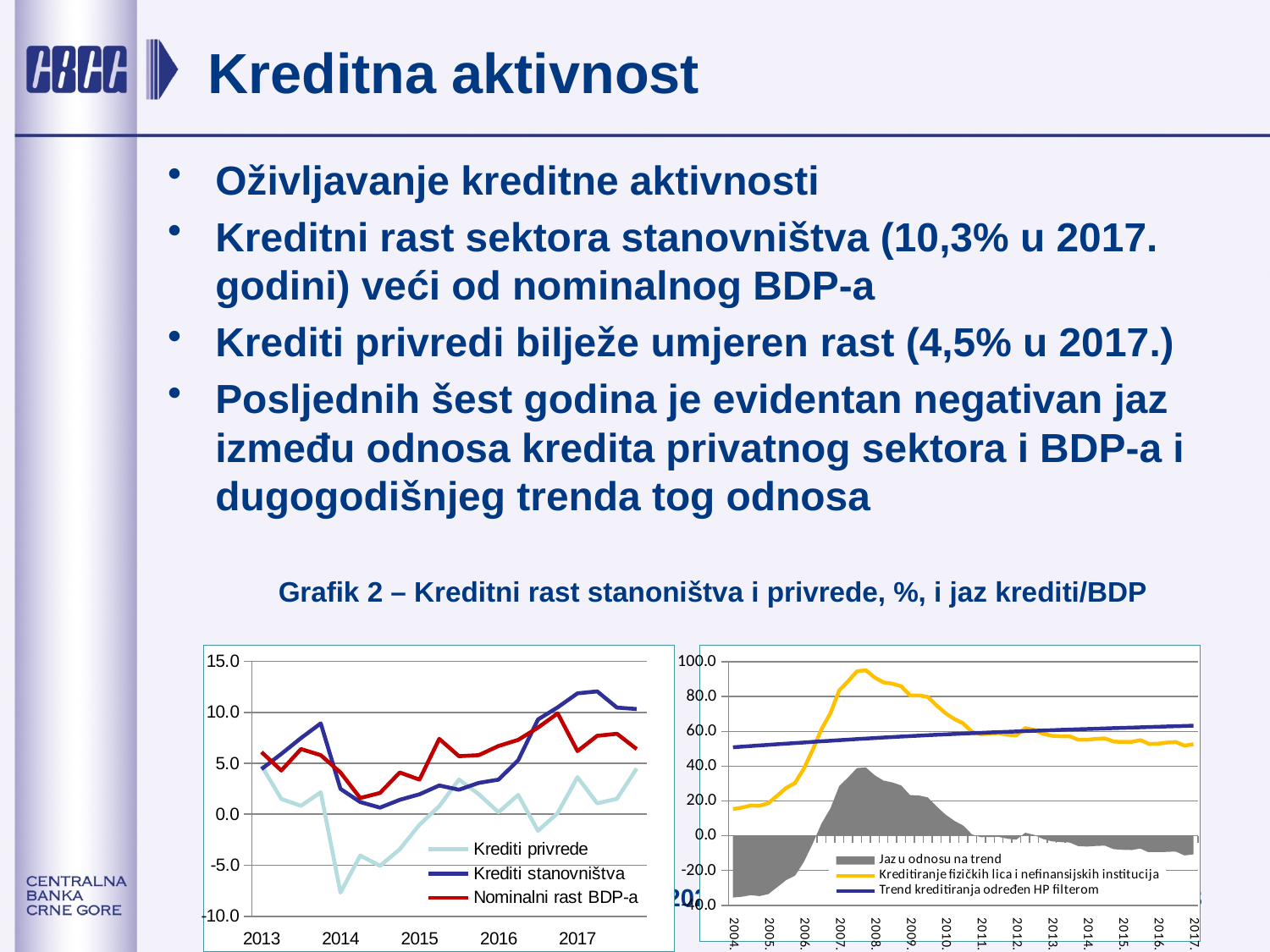
What is the title shown above the two charts? Grafik 2 – Kreditni rast stanoništva i privrede, %, i jaz krediti/BDP How many years are labelled on the x axis of the left chart? 5 In the left chart, is the lowest value of Krediti privrede in 2014 greater or less than -5.0? less In the left chart, is the peak value of Krediti stanovništva in 2017 greater or less than 10.0? greater In the right chart, which series has the highest value in 2008? Kreditiranje fizičkih lica i nefinansijskih institucija How many series does the legend of the left chart list? 3 How many series does the legend of the right chart list? 3 In the right chart, is the value of Jaz u odnosu na trend in 2004 greater or less than -20.0? less In the left chart, which series is higher in 2017: Krediti stanovništva or Krediti privrede? Krediti stanovništva In the right chart, does the Trend kreditiranja određen HP filterom line rise or fall from 2004 to 2017? rise What kind of chart is the left chart? line chart